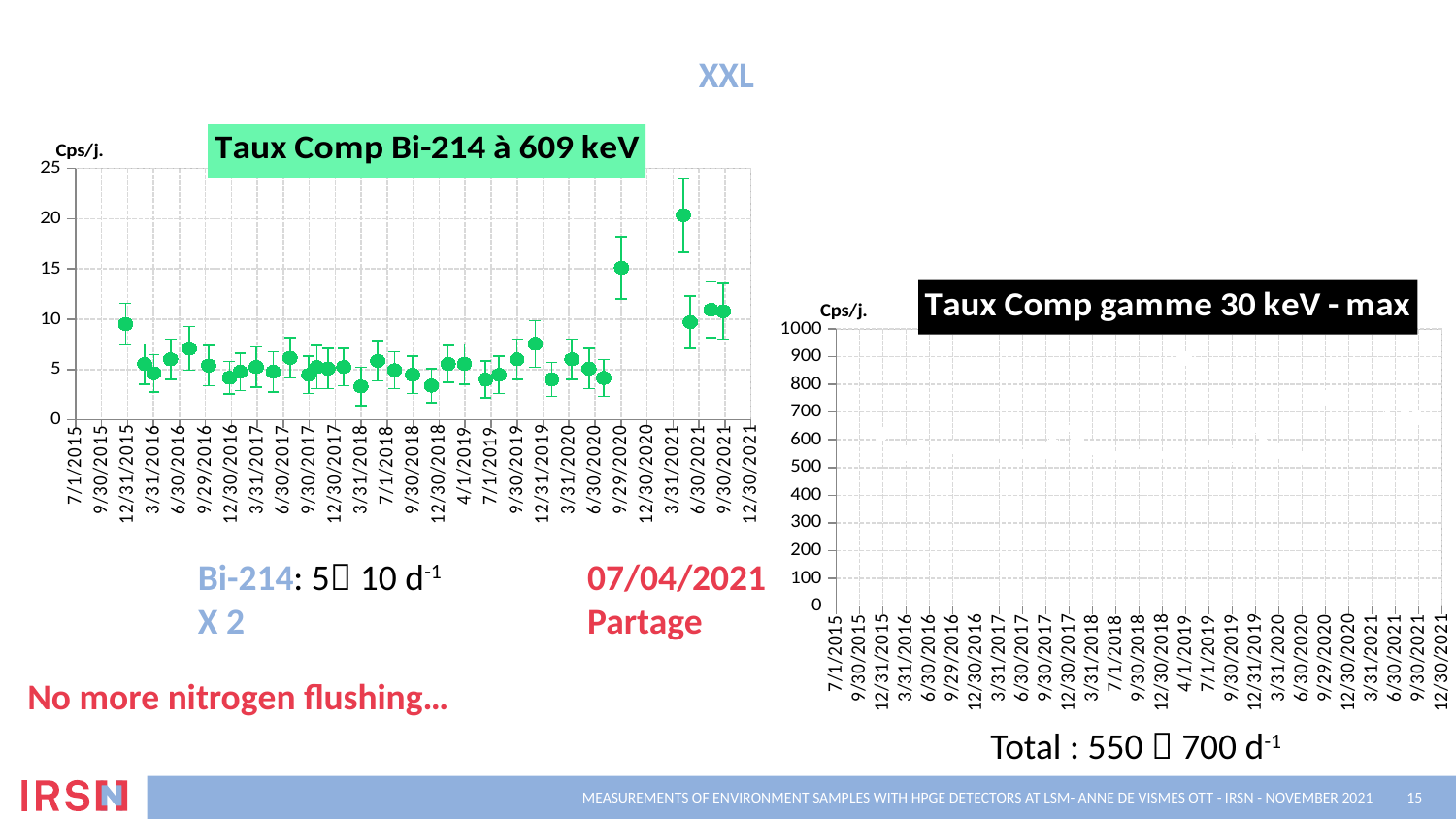
In the left chart 'Taux Comp Bi-214 à 609 keV', is the value at 12/30/2018 greater or less than 5? less What kind of chart is the left chart 'Taux Comp Bi-214 à 609 keV'? scatter chart In the left chart 'Taux Comp Bi-214 à 609 keV', is the value at 9/30/2021 greater or less than 10? greater In the left chart 'Taux Comp Bi-214 à 609 keV', which is larger: the value at 9/29/2020 or the value at 6/30/2021? 9/29/2020 In the left chart 'Taux Comp Bi-214 à 609 keV', is the value at 6/30/2021 greater or less than 5? greater In the left chart 'Taux Comp Bi-214 à 609 keV', do the values rise or fall between 6/30/2020 and 3/31/2021? rise What is the highest value shown on the y axis of the right chart 'Taux Comp gamme 30 keV - max'? 1000 What is the title of the chart on the right of the slide? Taux Comp gamme 30 keV - max